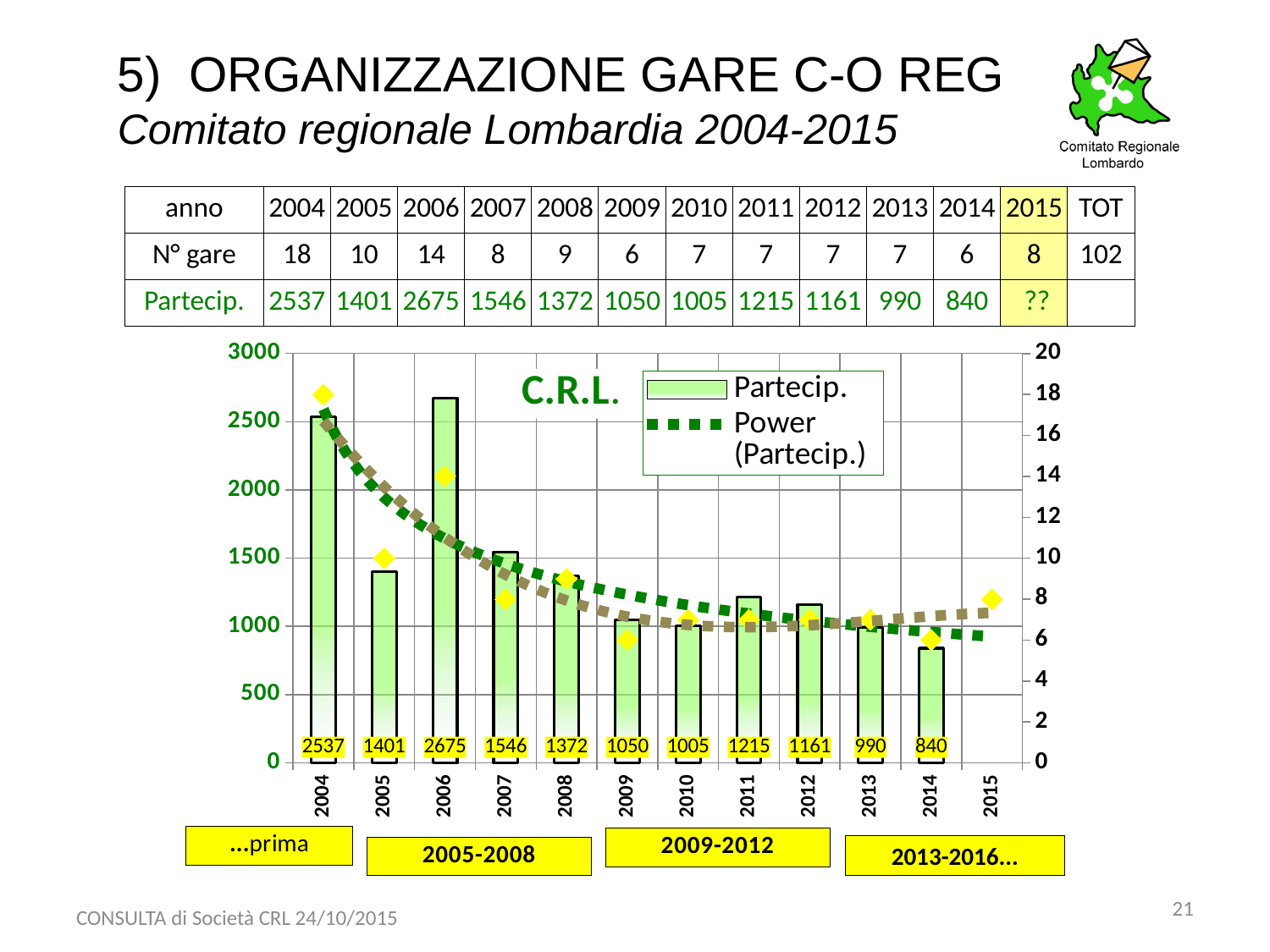
What is the difference between the Partecip. values for 2004 and 2005? 1136 Is the Partecip. value for 2009 greater or less than 1500? less How many years have a Partecip. bar plotted in the chart? 11 What is the Partecip. value for 2006? 2675 What is the Partecip. value for 2014? 840 What is the Partecip. value for 2010? 1005 Which year has the larger Partecip. value, 2011 or 2012? 2011 Which year has the lowest Partecip. bar? 2014 Which year has the highest Partecip. bar? 2006 How many series does the chart legend list? 2 Do the Partecip. values generally rise or fall from 2004 to 2014? fall What kind of chart is used to show the Partecip. values? bar chart